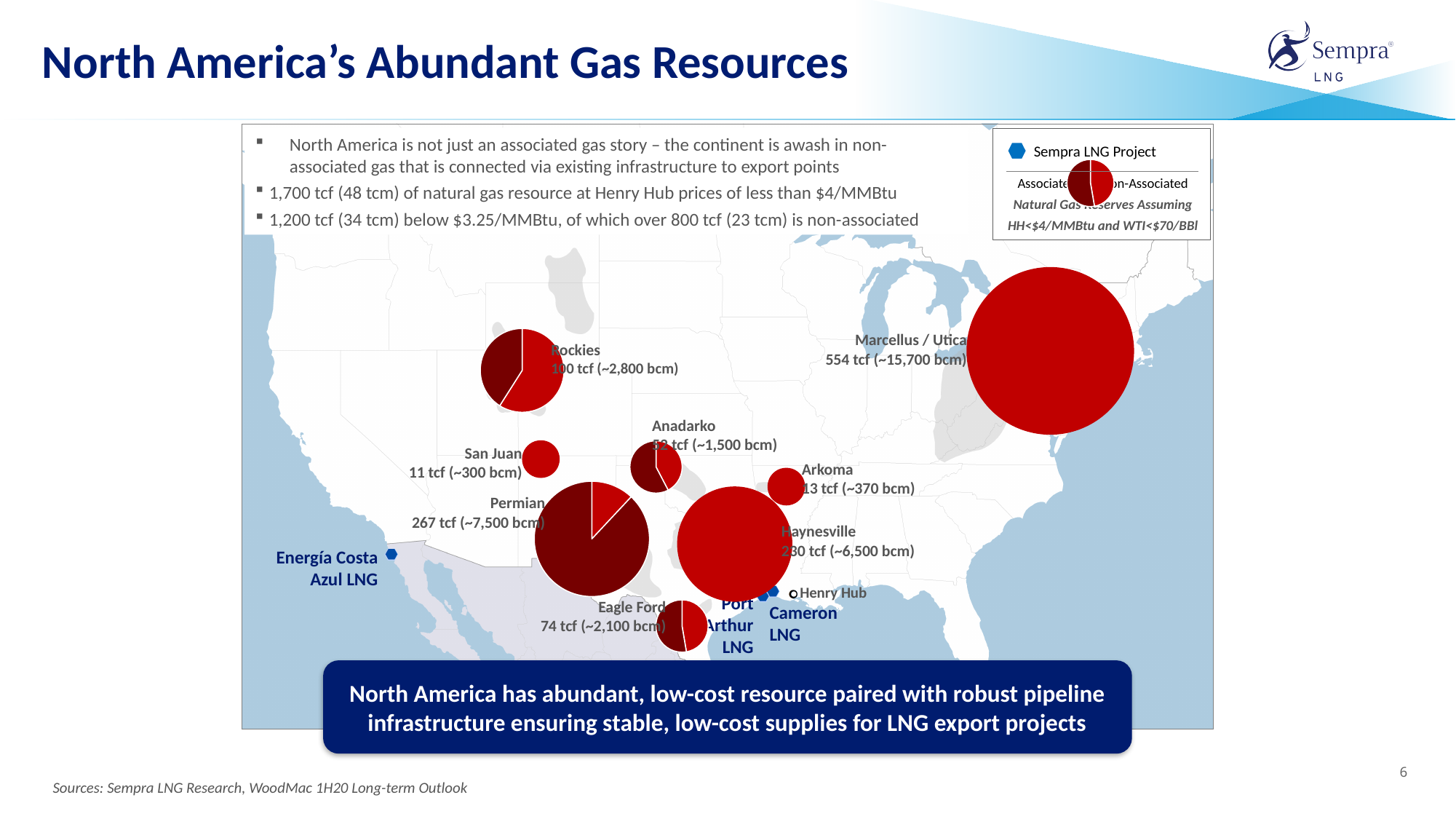
What is the natural gas resource value shown for the Marcellus / Utica basin in tcf? 554 tcf How much larger is the Marcellus / Utica resource than the Permian resource, in tcf? 287 tcf What is the natural gas resource value shown for San Juan in tcf? 11 tcf How many Sempra LNG projects are marked on the map? 3 Which basin on the map has the smallest natural gas resource? San Juan What two categories of gas reserves does the legend distinguish in the pie bubbles? Associated and Non-Associated What is the natural gas resource value shown for the Rockies in tcf? 100 tcf How many gas basins are labelled with resource values on the map? 8 Which basin on the map has the largest natural gas resource? Marcellus / Utica Which basin has the larger natural gas resource, Permian or Haynesville? Permian What is the natural gas resource value shown for the Permian basin in tcf? 267 tcf What is the natural gas resource value shown for Eagle Ford in tcf? 74 tcf